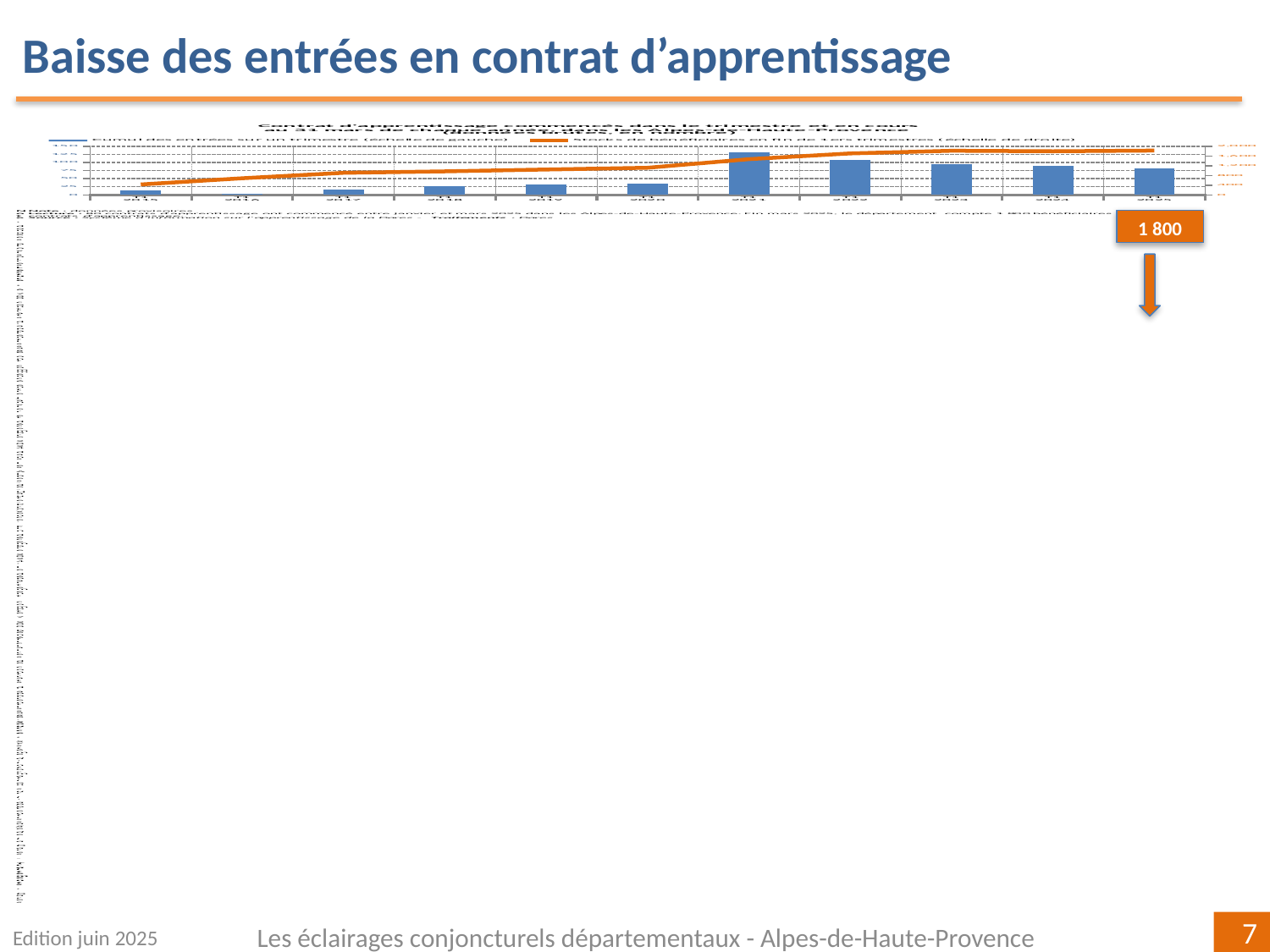
Do the bars rise or fall from 2021 to 2025? Fall Is the bar for 2021 taller or shorter than the bar for 2025? Taller What kind of chart is shown on the slide? A combination chart with bars and a line What is the last year shown on the x axis? 2025 What colour are the bars for 'Cumul des entrées sur un trimestre'? Blue How many years are shown along the x axis of the chart? 11 Which year has the tallest bar for 'Cumul des entrées sur un trimestre'? 2021 What is the first year shown on the x axis? 2015 Which series is plotted on the right-hand axis (échelle de droite)? Stocks de bénéficiaires en fin de 1ers trimestres How many series does the chart legend list? 2 Is the bar for 2019 taller or shorter than the bar for 2022? Shorter Does the orange line 'Stocks de bénéficiaires en fin de 1ers trimestres' rise or fall from 2015 to 2025? Rises